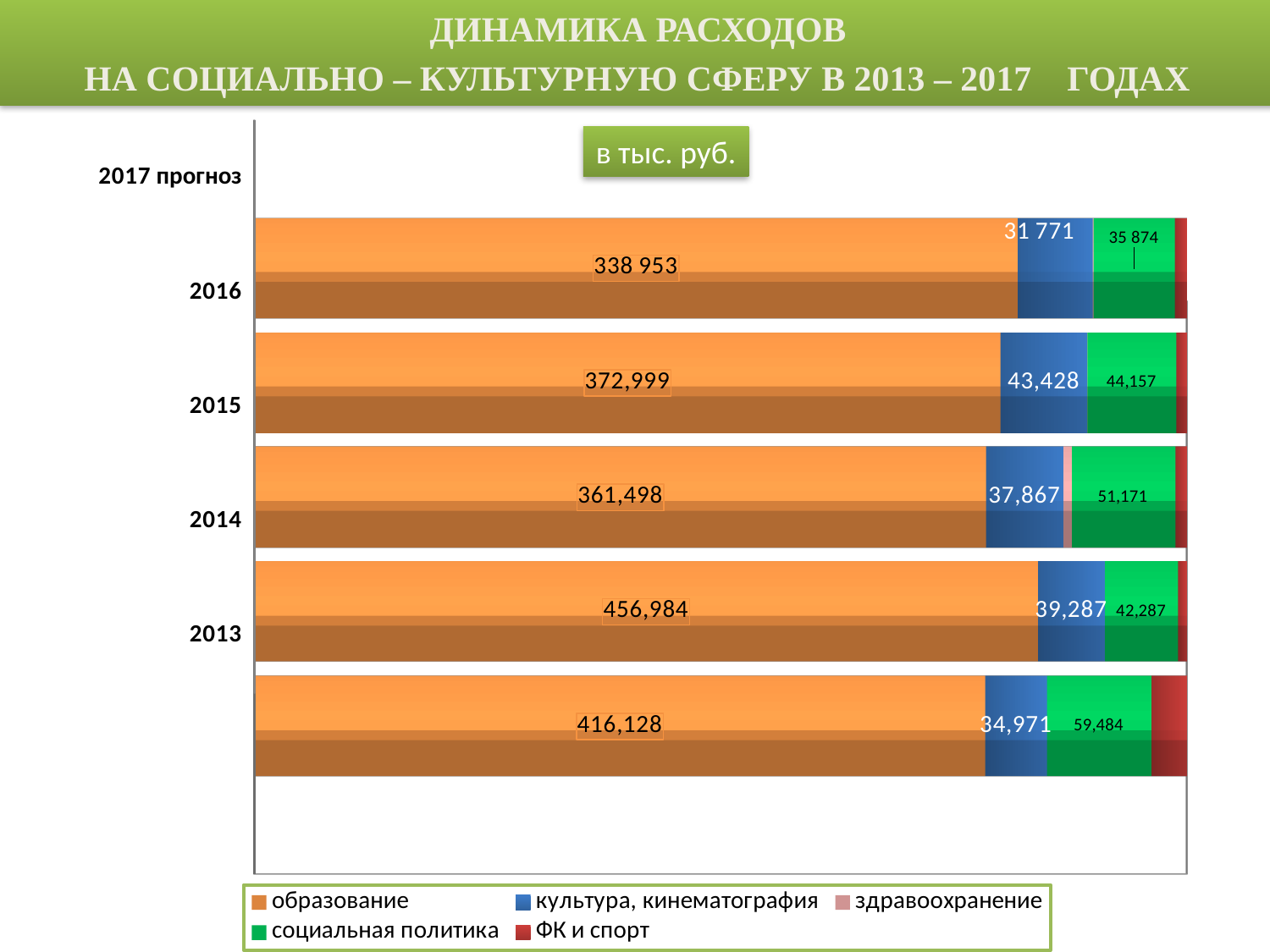
In what units are the values shown, according to the label on the chart? в тыс. руб. How many series does the legend list? 5 How many stacked bars are plotted in the chart? 5 What is the value of образование in the topmost bar? 338 953 Which bar has the largest образование value? The fourth bar from the top (456,984) What is the value of культура, кинематография in the second bar from the top? 43,428 What is the value of социальная политика in the bottom bar? 59,484 Which is larger: the культура, кинематография value in the second bar from the top or in the third bar from the top? The second bar from the top (43,428) Which bar has the smallest образование value? The topmost bar (338 953) What type of chart is shown on the slide? Stacked bar chart What is the difference between the образование value in the fourth bar from the top (456,984) and in the bottom bar (416,128)? 40,856 Which bar has the largest социальная политика value? The bottom bar (59,484)